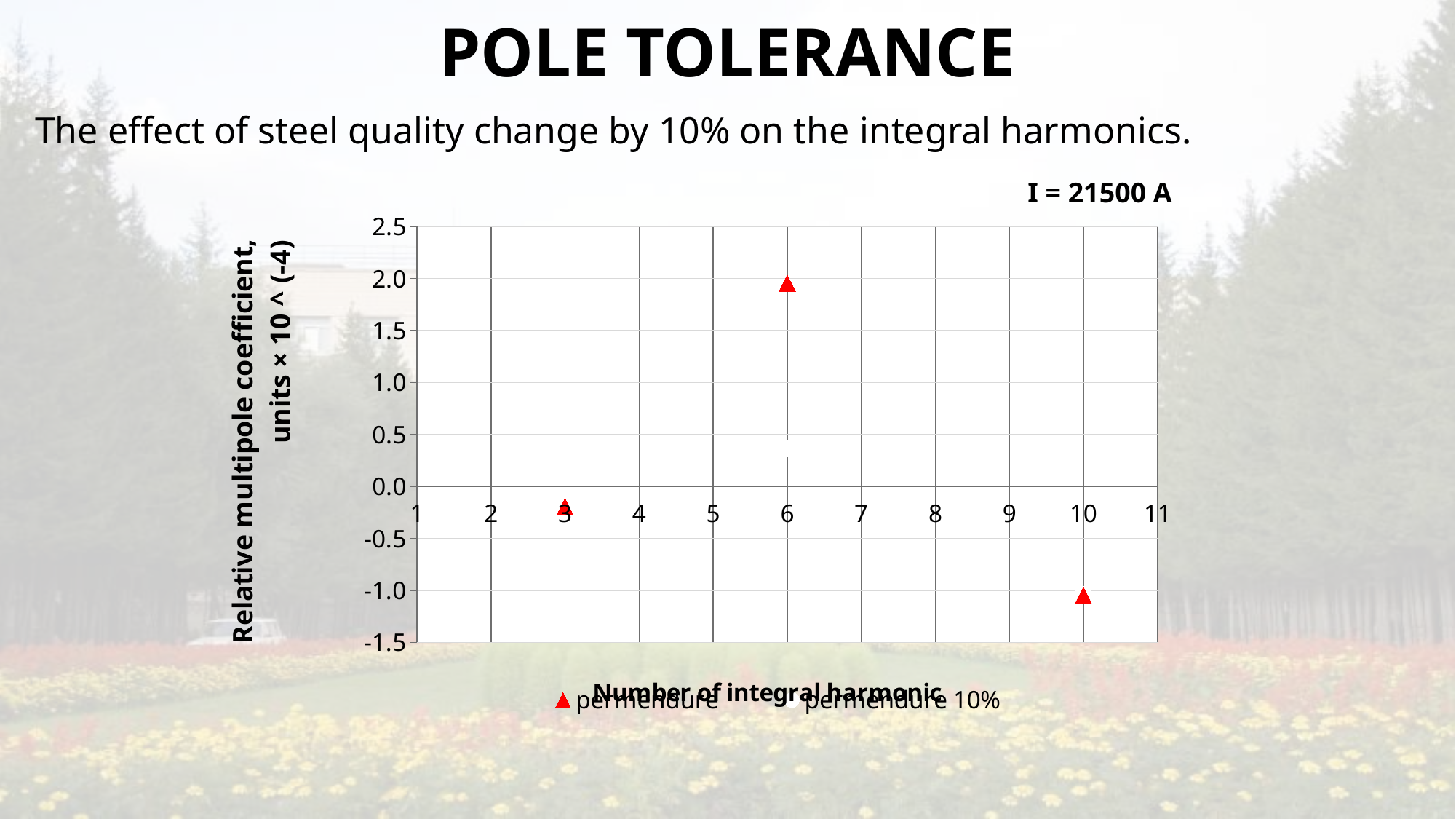
Is the value plotted at harmonic 6 greater or less than 1.5? greater At which integral harmonic number is the plotted relative multipole coefficient highest? 6 How many series does the legend list? 2 Is the value plotted at harmonic 10 greater or less than -0.5? less What kind of chart is shown on the slide? scatter chart What current value is annotated above the chart? I = 21500 A Is the value plotted at harmonic 3 greater or less than 0.5? less What are the two series names in the legend? permendure; permendure 10% Which has the larger plotted value, harmonic 3 or harmonic 10? harmonic 3 Which has the larger plotted value, harmonic 3 or harmonic 6? harmonic 6 At which integral harmonic number is the plotted relative multipole coefficient lowest? 10 How many red triangle data points are plotted for the permendure series? 3